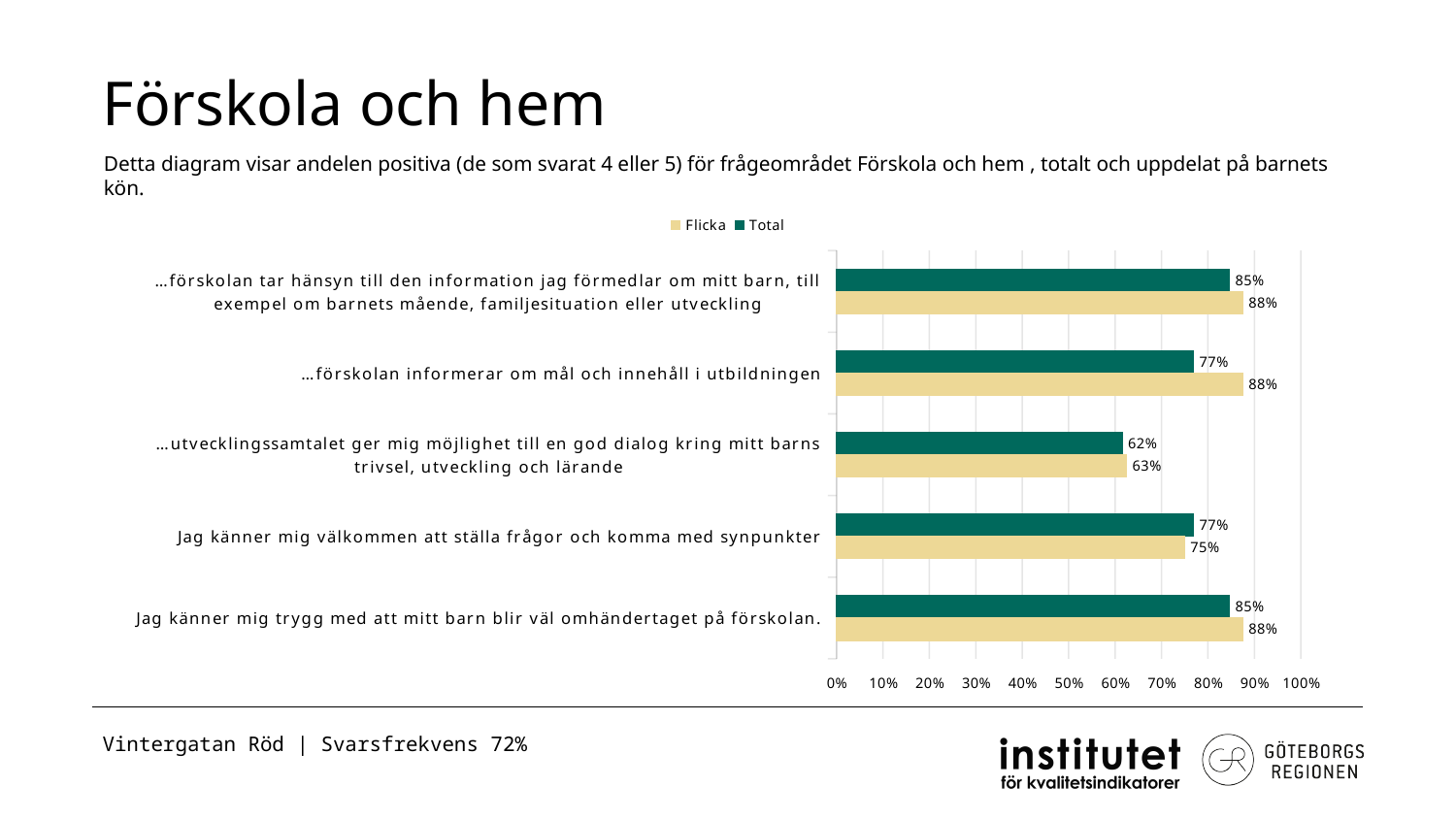
What is the Total value for "…förskolan informerar om mål och innehåll i utbildningen"? 77% What is the difference between the Flicka and Total values for "…förskolan informerar om mål och innehåll i utbildningen"? 11 percentage points What is the Flicka value for "…förskolan informerar om mål och innehåll i utbildningen"? 88% What is the Flicka value for "Jag känner mig välkommen att ställa frågor och komma med synpunkter"? 75% What kind of chart is shown on the slide? bar chart Which series is shown in dark green in the legend? Total What is the Total value for "Jag känner mig trygg med att mitt barn blir väl omhändertaget på förskolan."? 85% How many series does the legend list? 2 How many statements (categories) are plotted in the chart? 5 Which statement has the lowest Total value? …utvecklingssamtalet ger mig möjlighet till en god dialog kring mitt barns trivsel, utveckling och lärande For "Jag känner mig välkommen att ställa frågor och komma med synpunkter", which is larger, the Flicka value or the Total value? Total What is the Flicka value for "…utvecklingssamtalet ger mig möjlighet till en god dialog kring mitt barns trivsel, utveckling och lärande"? 63%